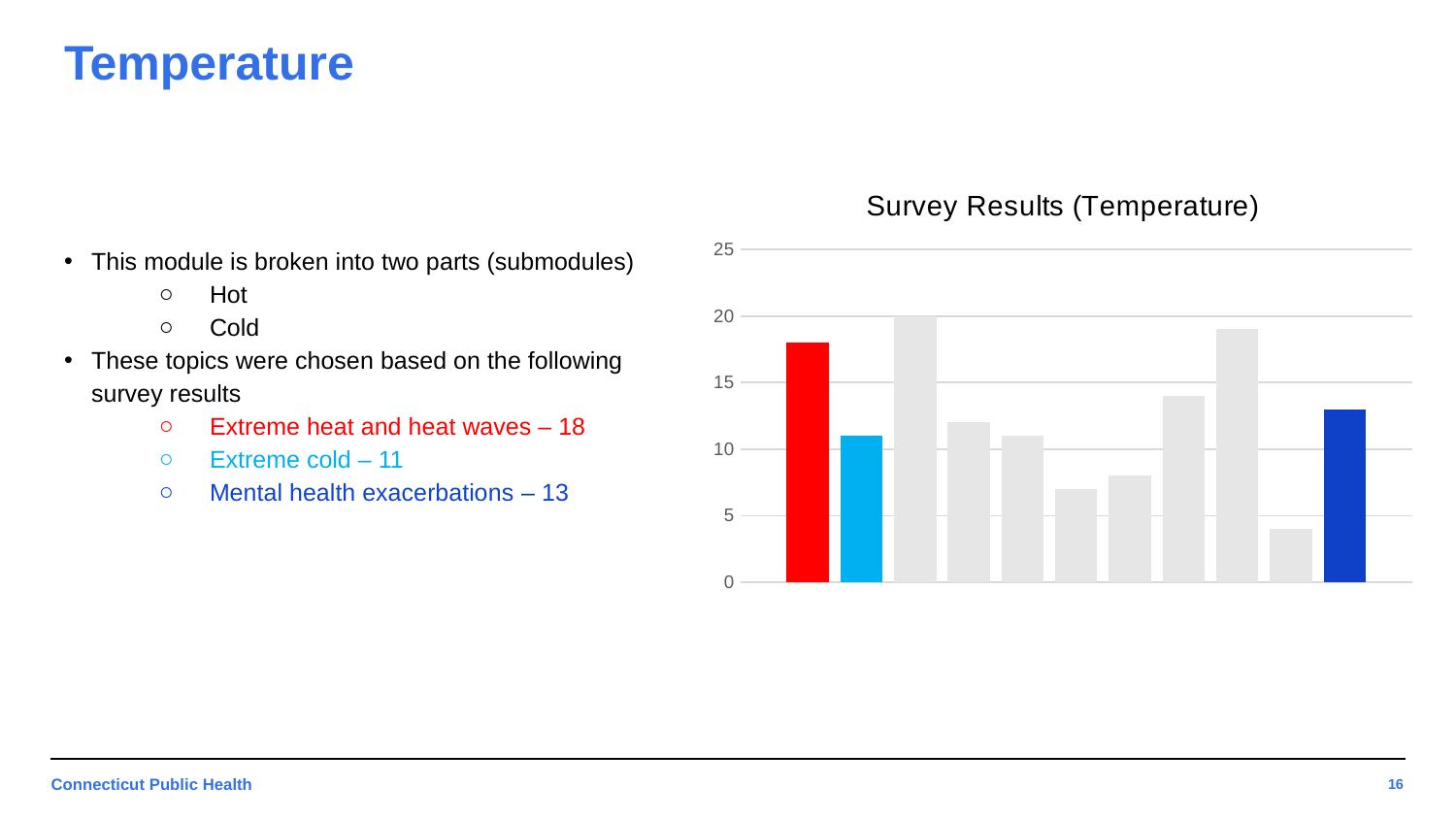
Which is taller, the red bar or the light blue bar? the red bar Is the value of the dark blue bar greater or less than 10? greater What value does the tallest bar in the chart reach? 20 What is the highest value shown on the y axis of the chart? 25 According to the slide, what is the difference between the Extreme heat and heat waves result and the Extreme cold result? 7 What is the title of the chart on the slide? Survey Results (Temperature) How many bars are plotted in the Survey Results (Temperature) chart? 11 Is the value of the red bar greater or less than 15? greater What kind of chart is shown on the slide? bar chart According to the slide, what survey result value corresponds to the red bar (Extreme heat and heat waves)? 18 Which is taller, the dark blue bar or the light blue bar? the dark blue bar Is the value of the light blue bar greater or less than 15? less